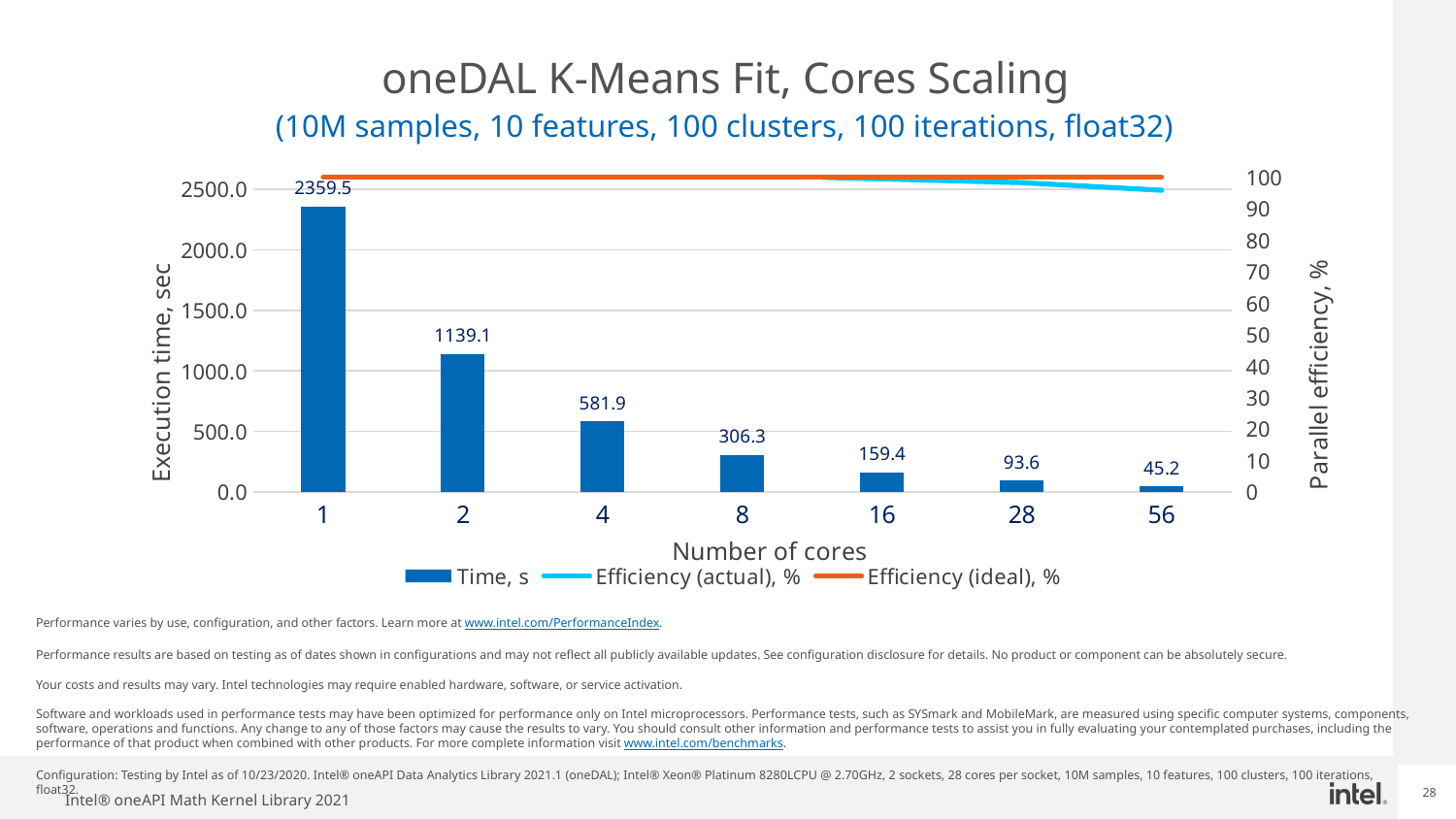
What is the label of the left vertical axis? Execution time, sec What is the execution time for 8 cores? 306.3 Which number of cores has the highest execution time? 1 Does the execution time rise or fall as the number of cores increases? fall What is the difference in execution time between 1 core and 2 cores? 1220.4 What is the execution time for 1 core? 2359.5 How many series does the legend list? 3 How many core counts are plotted on the x axis? 7 What is the difference in execution time between 16 cores and 28 cores? 65.8 Which has a larger execution time, 4 cores or 8 cores? 4 cores What is the execution time for 56 cores? 45.2 Which number of cores has the lowest execution time? 56